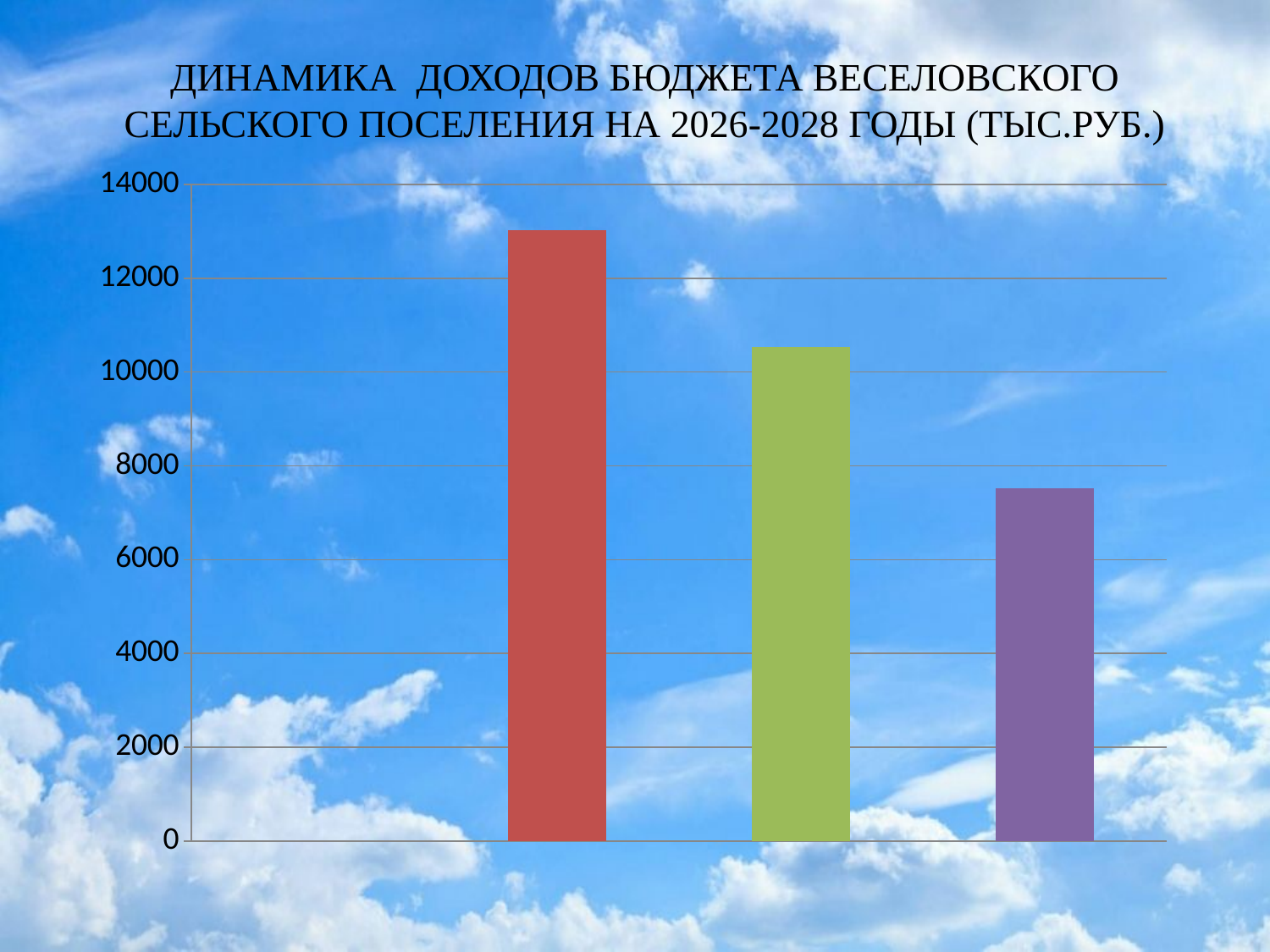
Which bar is the shortest: the red (first), green (second) or purple (third)? the purple (third) bar Is the value of the green (second) bar greater or less than 10000? greater Is the value of the red (first) bar greater or less than 12000? greater Is the value of the purple (third) bar greater or less than 8000? less What kind of chart is shown on the slide? bar chart Do the bar values rise or fall from left to right? fall Which bar is the tallest: the red (first), green (second) or purple (third)? the red (first) bar Which is larger, the green (second) bar or the purple (third) bar? the green (second) bar How many bars does the chart show? 3 In what units are the values given according to the chart title? тыс.руб. What is the highest value shown on the vertical axis? 14000